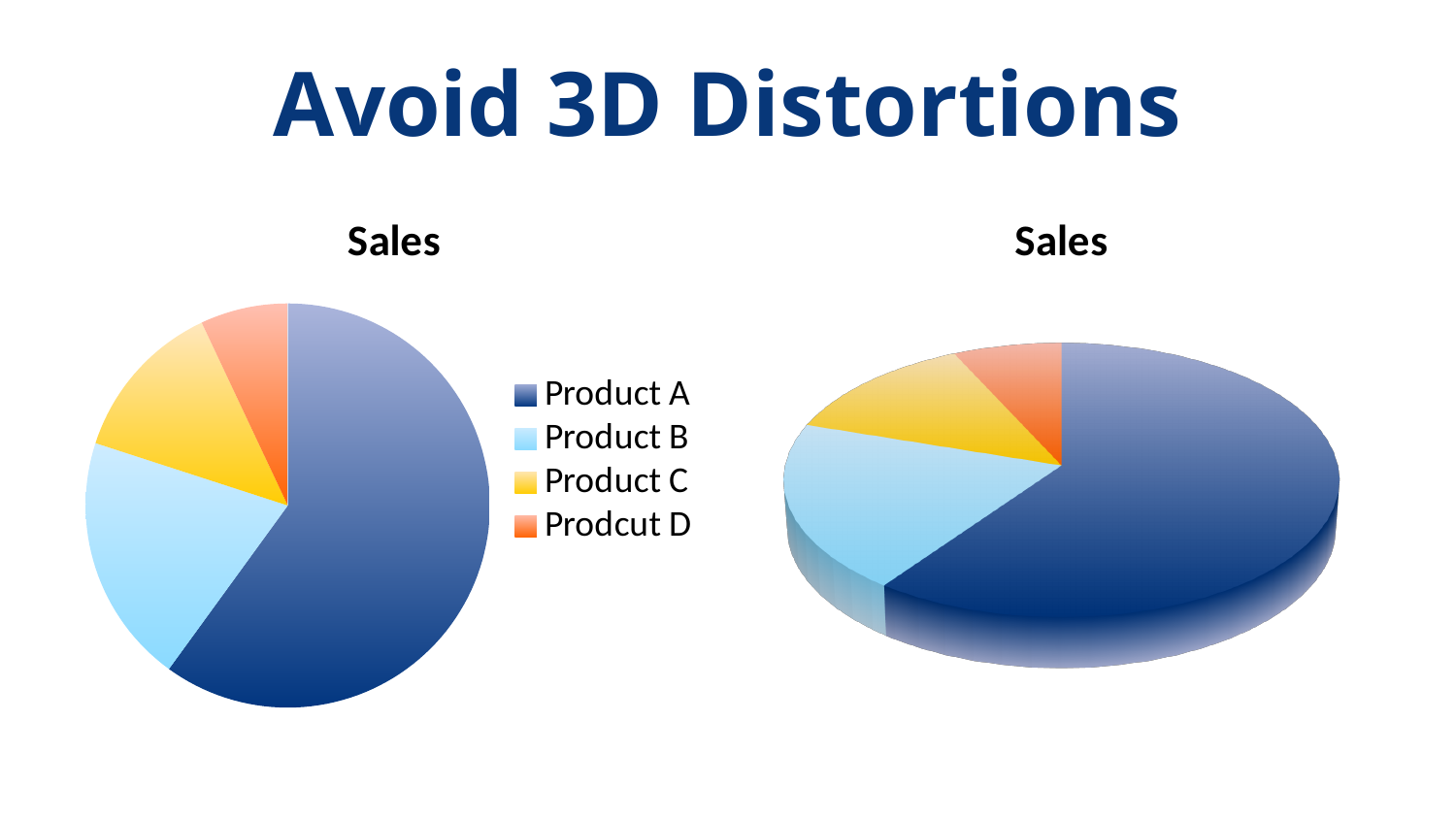
What kind of chart is the right chart on the slide? 3D pie chart In the right pie chart, which product has the largest slice? Product A In the left pie chart, which product has the largest slice? Product A In the left pie chart, which is larger, the slice for Product B or the slice for Product C? Product B In the left pie chart, which product has the smallest slice? Prodcut D How many entries does the legend list? 4 In the right pie chart, which is larger, the slice for Product A or the slice for Product C? Product A What kind of chart is the left chart on the slide? pie chart Which colour represents Product C in the legend? yellow In the left pie chart, which is larger, the slice for Product A or the slice for Product B? Product A What is the title of the left chart? Sales In the left pie chart, how many slices are there? 4